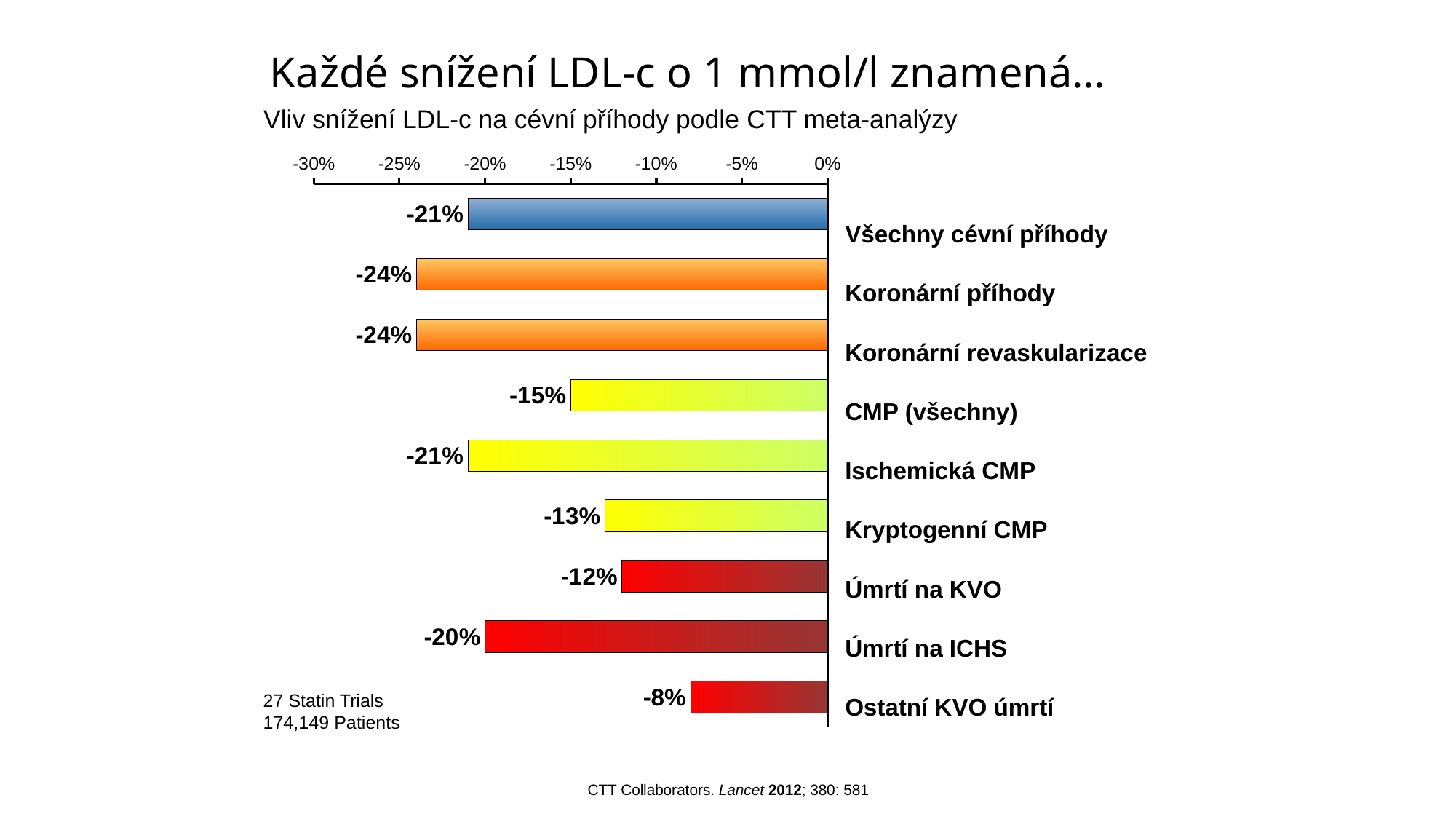
What is the value shown for Ostatní KVO úmrtí? -8% How many categories are plotted in the chart? 9 Which category shows the smallest reduction (the shortest bar)? Ostatní KVO úmrtí What is the value shown for CMP (všechny)? -15% Which shows a larger reduction, Ischemická CMP or Kryptogenní CMP? Ischemická CMP Which shows a larger reduction, Úmrtí na ICHS or Úmrtí na KVO? Úmrtí na ICHS What kind of chart is shown on the slide? Bar chart What is the value shown for Kryptogenní CMP? -13% What is the subtitle of the chart shown below the slide title? Vliv snížení LDL-c na cévní příhody podle CTT meta-analýzy What is the value shown for Úmrtí na KVO? -12% What is the value shown for Koronární příhody? -24% By how many percentage points does the reduction for Koronární příhody exceed the reduction for CMP (všechny)? 9 percentage points